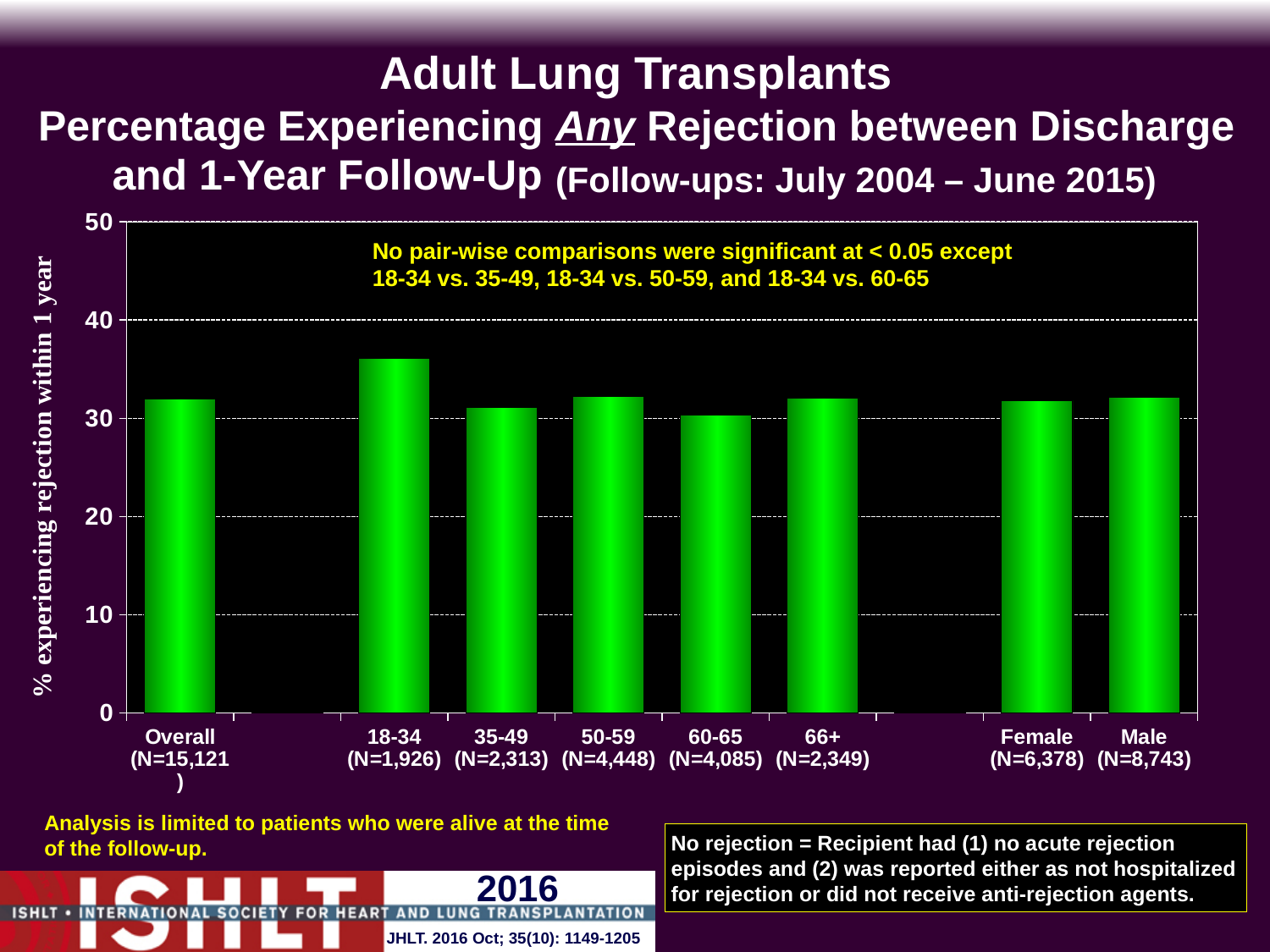
What is the label on the y axis? % experiencing rejection within 1 year What kind of chart is shown on the slide? bar chart Is the value for Female greater or less than 20? greater Is the value for the 60-65 age group greater or less than 40? less What is the sample size (N) shown for the Overall category? N=15,121 Which category has the highest percentage experiencing rejection within 1 year? 18-34 Is the value for the 18-34 age group greater or less than 40? less How many bars (categories) are plotted on the chart? 8 Which is larger, the value for 18-34 or the value for 35-49? 18-34